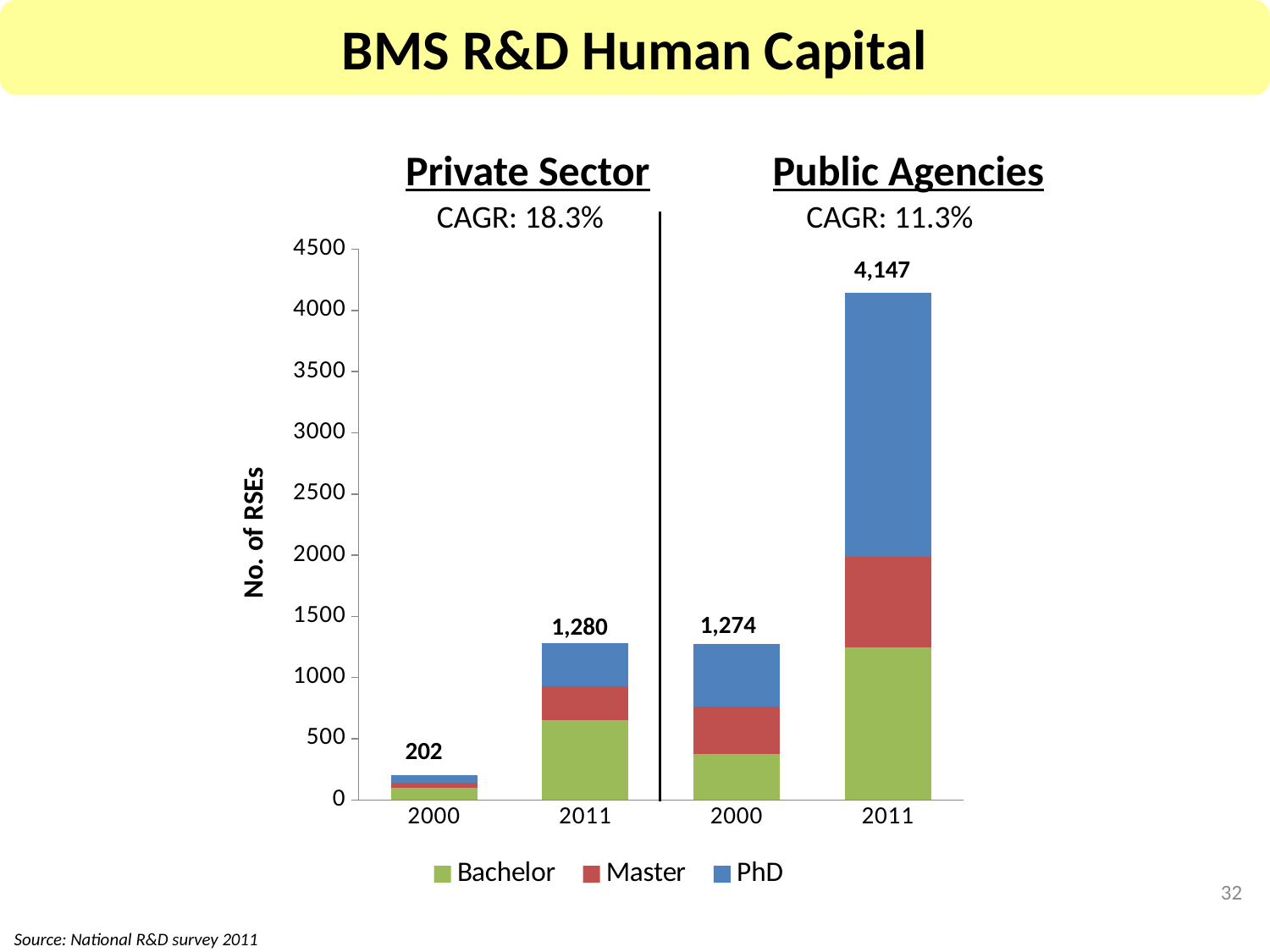
What is the total number of RSEs for the Private Sector in 2011? 1,280 By how much did the total number of RSEs in the Private Sector increase from 2000 to 2011? 1,078 Which bar has the lowest total number of RSEs? Private Sector 2000 By how much did the total number of RSEs in Public Agencies increase from 2000 to 2011? 2,873 Which bar has the highest total number of RSEs? Public Agencies 2011 Is the Bachelor segment for Public Agencies in 2011 greater or less than 1000? greater How many series does the legend list? 3 What type of chart is shown on the slide? stacked bar chart What is the CAGR shown for the Private Sector? 18.3% What is the total number of RSEs for Public Agencies in 2000? 1,274 What is the total number of RSEs for the Private Sector in 2000? 202 What is the total number of RSEs for Public Agencies in 2011? 4,147